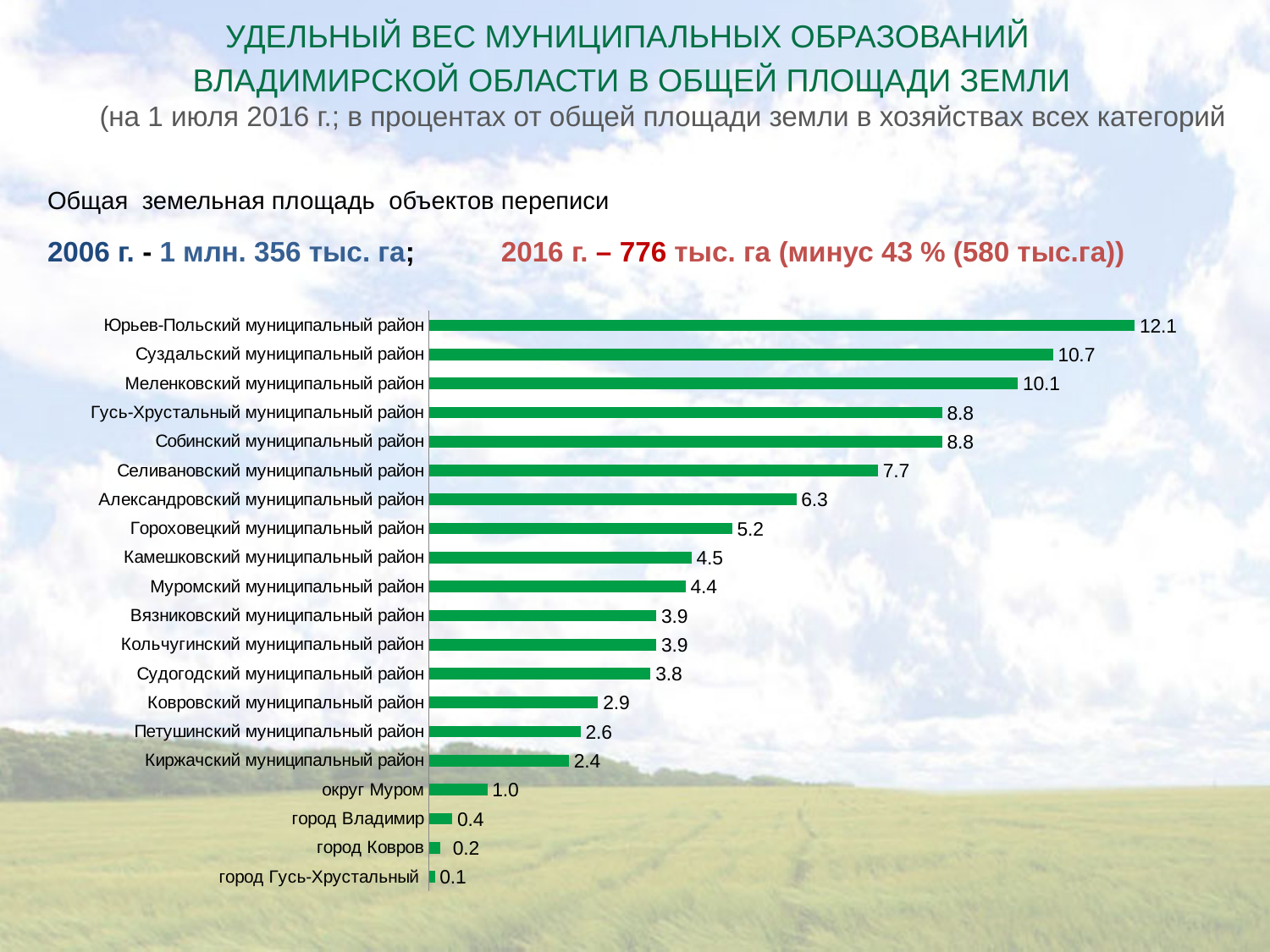
What colour are the bars in the chart? green What is the value for Юрьев-Польский муниципальный район? 12.1 How many categories are shown in the chart? 20 What is the value for округ Муром? 1.0 Which category has the highest value? Юрьев-Польский муниципальный район What is the value for Гороховецкий муниципальный район? 5.2 What kind of chart is shown on the slide? bar chart What is the difference between the values for Ковровский муниципальный район and Киржачский муниципальный район? 0.5 Which is larger: the value for Селивановский муниципальный район or Александровский муниципальный район? Селивановский муниципальный район Which category has the lowest value? город Гусь-Хрустальный What is the value for город Владимир? 0.4 What is the difference between the values for Суздальский муниципальный район and Меленковский муниципальный район? 0.6